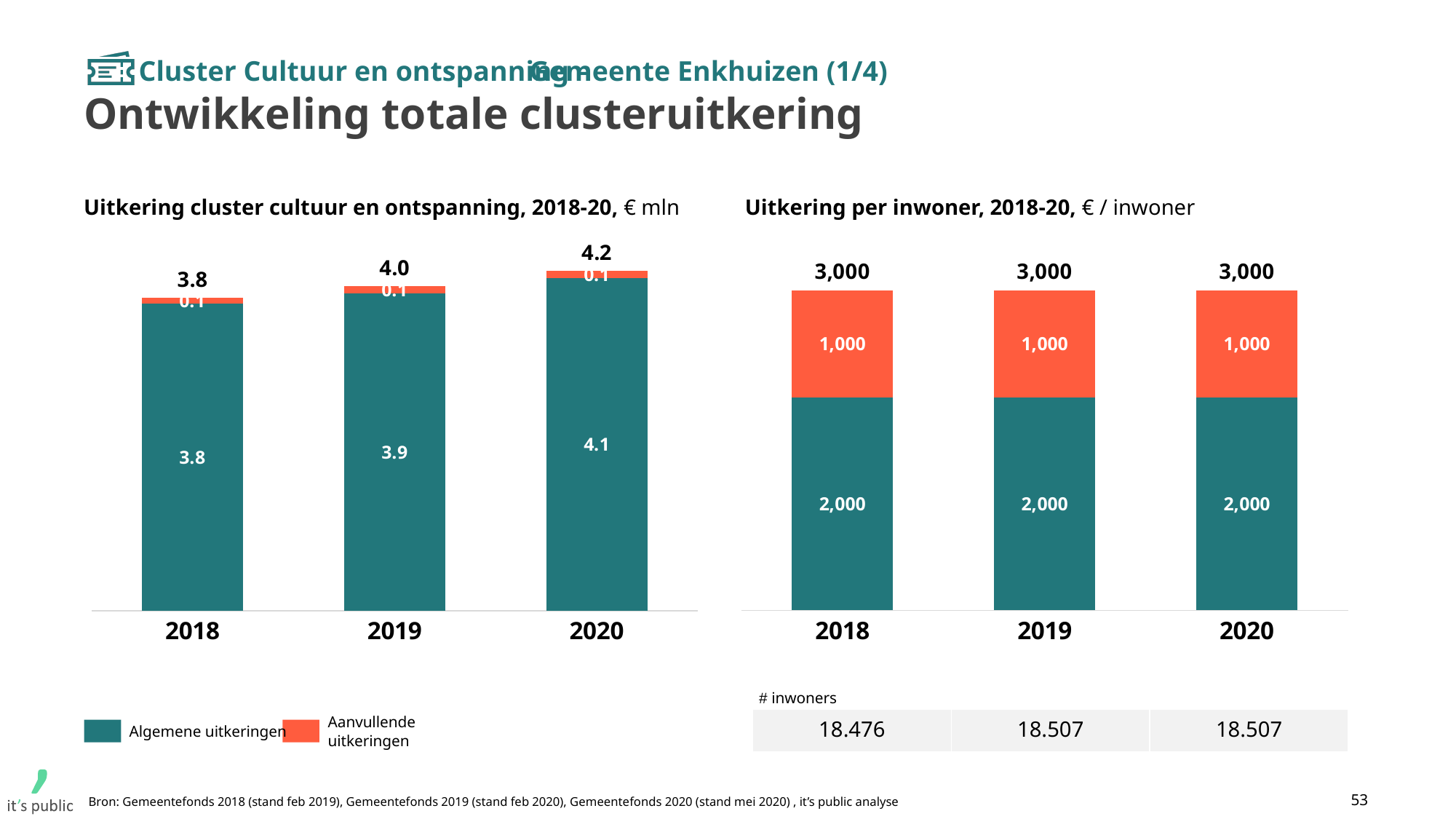
In the chart 'Uitkering cluster cultuur en ontspanning, 2018-20', what is the value of Algemene uitkeringen for 2019? 3.9 In the chart 'Uitkering cluster cultuur en ontspanning, 2018-20', do the totals rise or fall from 2018 to 2020? rise In the chart 'Uitkering per inwoner, 2018-20', what is the total shown above the bar for 2019? 3,000 What type of chart is 'Uitkering per inwoner, 2018-20'? stacked bar chart In the chart 'Uitkering cluster cultuur en ontspanning, 2018-20', which year has the lowest total? 2018 In the chart 'Uitkering per inwoner, 2018-20', what is the difference between the Algemene uitkeringen segment and the Aanvullende uitkeringen segment for 2020? 1,000 In the chart 'Uitkering cluster cultuur en ontspanning, 2018-20', which year has the highest total? 2020 How many series does the legend list for the charts on this slide? 2 In the chart 'Uitkering cluster cultuur en ontspanning, 2018-20', what is the total value shown above the bar for 2020? 4.2 In the chart 'Uitkering cluster cultuur en ontspanning, 2018-20', what is the difference between the total for 2020 and the total for 2018? 0.4 In the chart 'Uitkering per inwoner, 2018-20', what is the value of the Algemene uitkeringen segment for 2018? 2,000 In the chart 'Uitkering cluster cultuur en ontspanning, 2018-20', what is the value of Aanvullende uitkeringen for 2020? 0.1